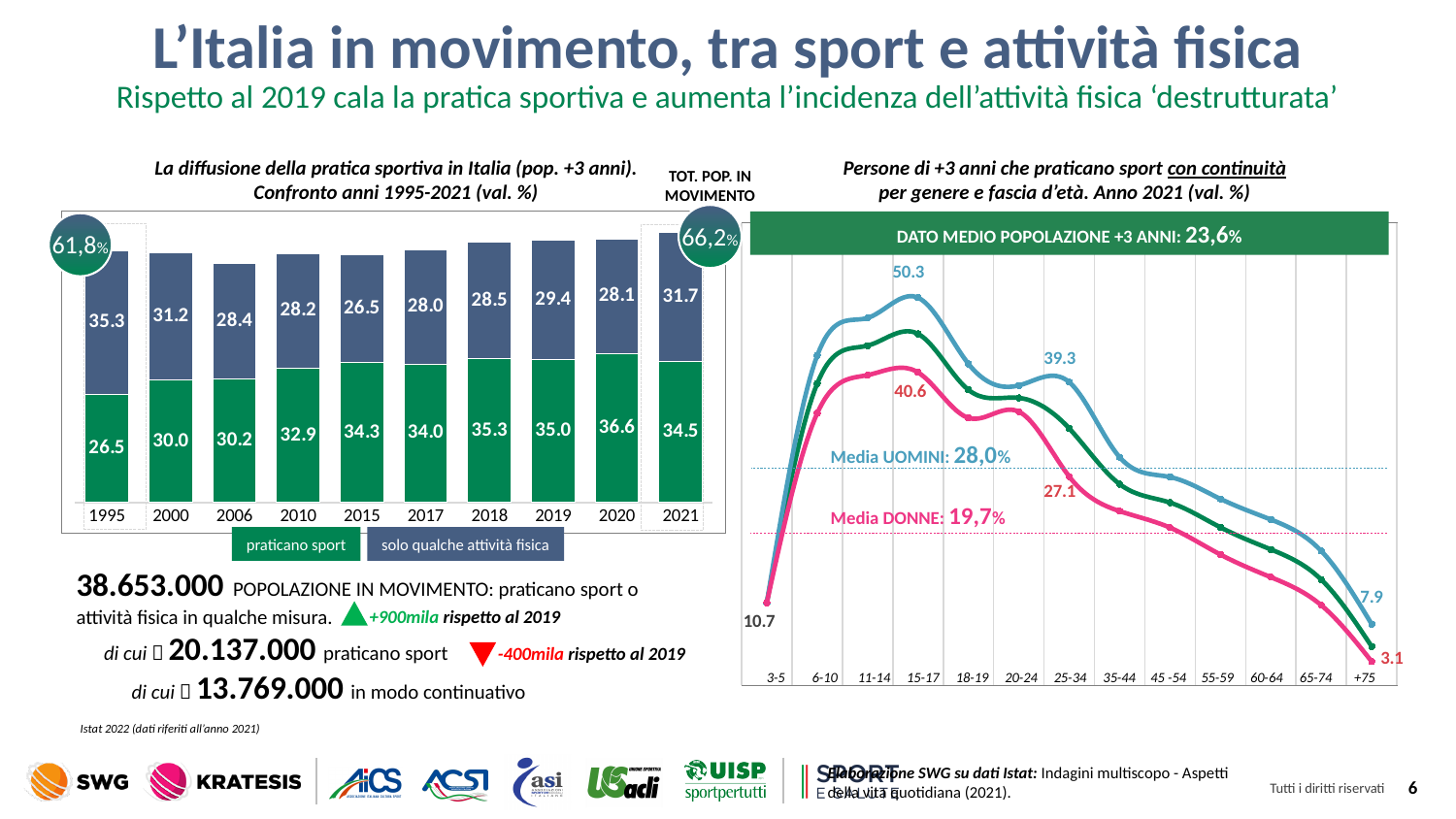
In the left chart (La diffusione della pratica sportiva in Italia), what is the value for 'praticano sport' in 2021? 34.5 In the left chart (La diffusione della pratica sportiva in Italia), how many series does the legend list? 2 In the left chart (La diffusione della pratica sportiva in Italia), how many years are shown on the x axis? 10 In the left chart (La diffusione della pratica sportiva in Italia), what is the value for 'solo qualche attività fisica' in 1995? 35.3 In the left chart (La diffusione della pratica sportiva in Italia), which year has the highest value for 'praticano sport'? 2020 In the left chart (La diffusione della pratica sportiva in Italia), which year has the lowest value for 'praticano sport'? 1995 In the right chart (Persone di +3 anni che praticano sport con continuità), what is the value for men (uomini) in the 15-17 age group? 50.3 In the left chart (La diffusione della pratica sportiva in Italia), what is the difference between the 'praticano sport' values for 2019 and 2021? 0.5 In the right chart (Persone di +3 anni che praticano sport con continuità), do the values rise or fall from the 25-34 age group to the +75 age group? fall In the right chart (Persone di +3 anni che praticano sport con continuità), how many age groups are shown on the x axis? 13 What kind of chart is the right chart (Persone di +3 anni che praticano sport con continuità)? line chart In the left chart (La diffusione della pratica sportiva in Italia), what is the total of the stacked bar for 2021? 66,2%